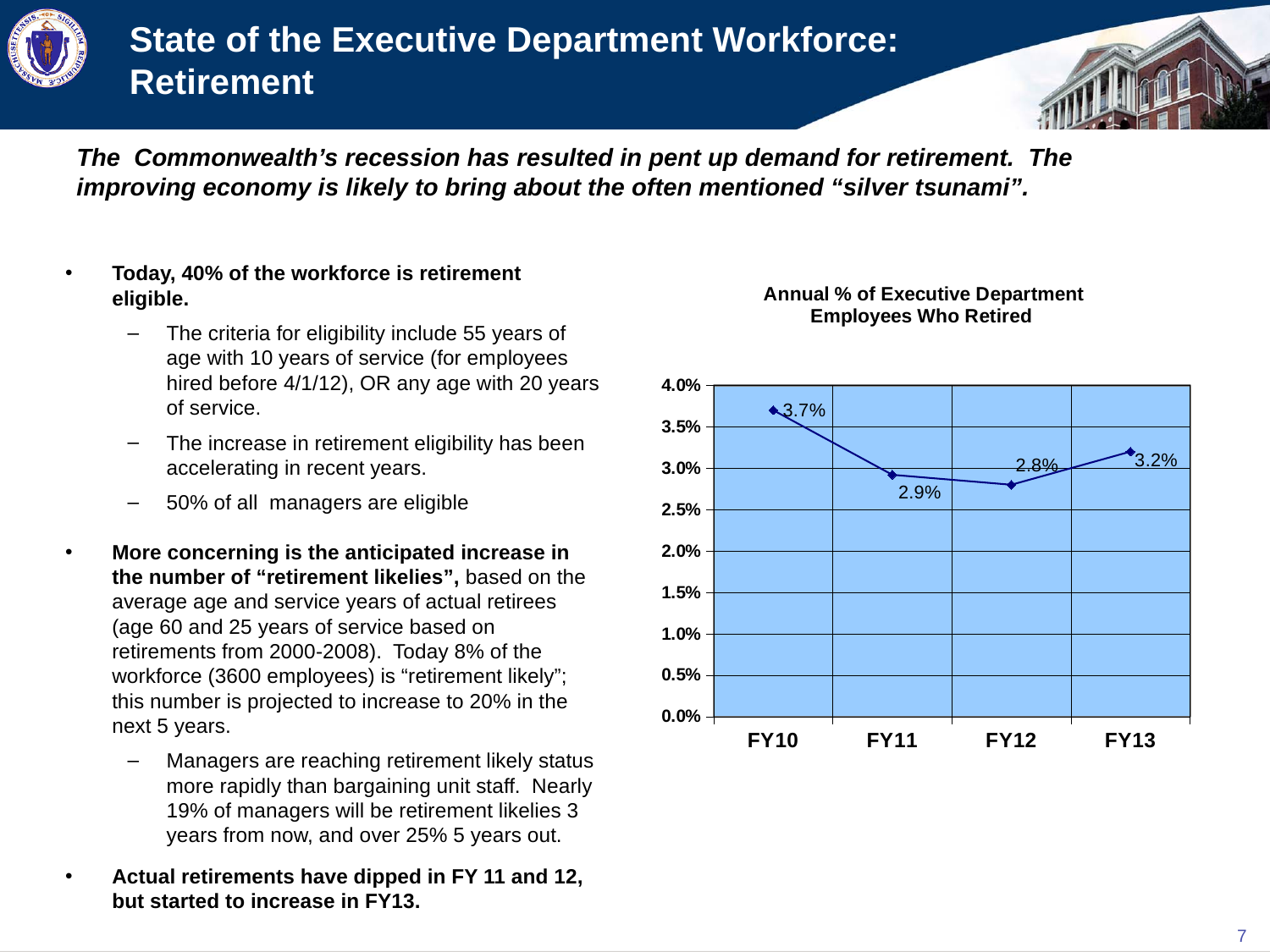
What is the value for FY13 in the chart? 3.2% Is the value for FY11 greater or less than 3.0%? less How many fiscal years are plotted in the chart? 4 Which fiscal year has the highest percentage of employees who retired? FY10 Which is larger, the value for FY11 or the value for FY13? FY13 Does the value rise or fall from FY12 to FY13? rise Which fiscal year has the lowest percentage of employees who retired? FY12 What is the value for FY12 in the chart? 2.8% What is the value for FY10 in the chart? 3.7% What is the difference between the FY10 and FY12 values? 0.9% What is the title of the chart? Annual % of Executive Department Employees Who Retired What kind of chart is shown on the slide? line chart